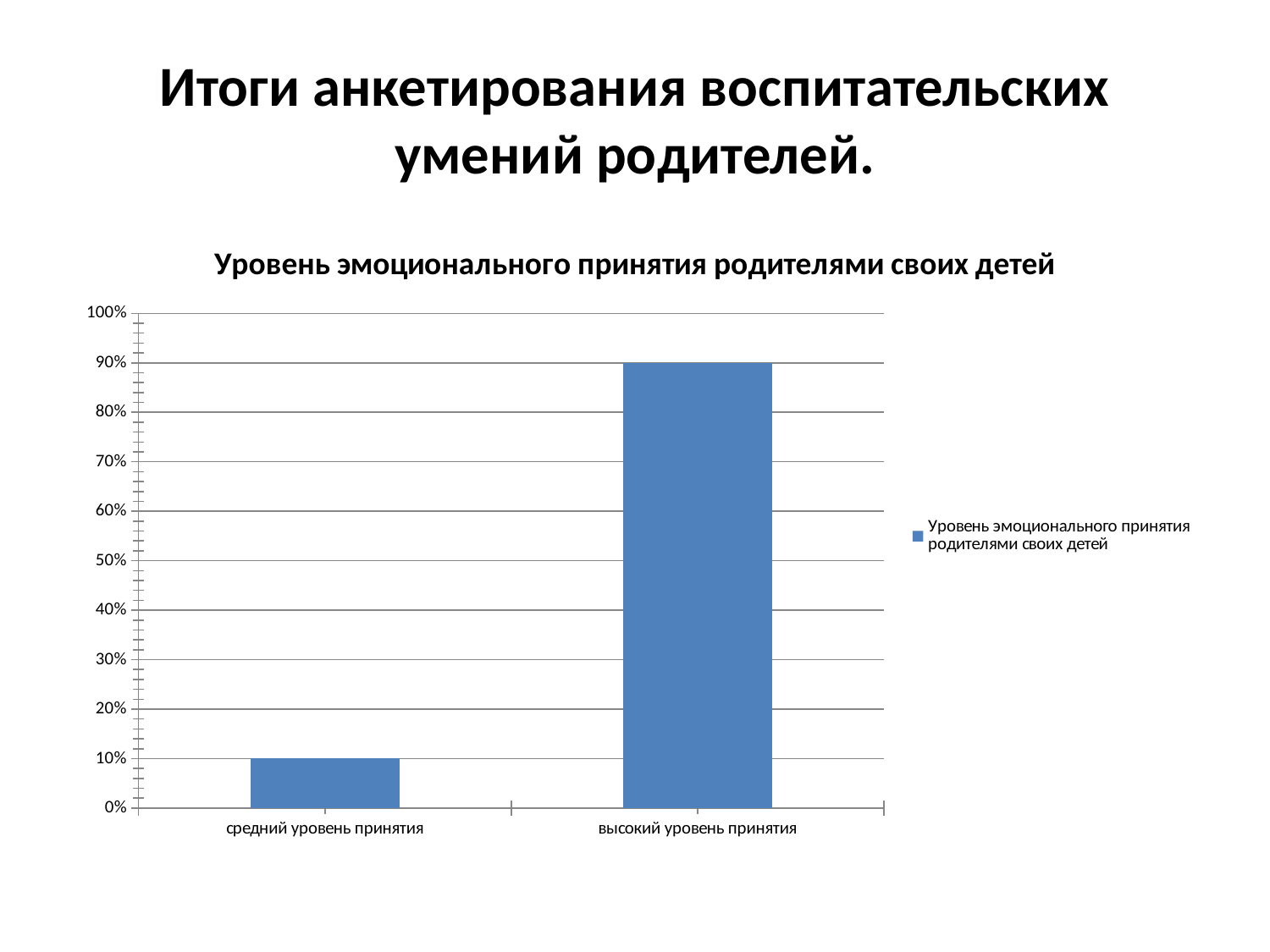
Which is larger: the value for "средний уровень принятия" or the value for "высокий уровень принятия"? высокий уровень принятия What is the value for "средний уровень принятия"? 10% What is the difference between the values for "высокий уровень принятия" and "средний уровень принятия"? 80% Is the value for "высокий уровень принятия" greater or less than 50%? greater How many categories are shown on the x axis? 2 Which category has the lowest value? средний уровень принятия Is the value for "средний уровень принятия" greater or less than 20%? less Which category has the highest value? высокий уровень принятия What is the value for "высокий уровень принятия"? 90% How many series does the legend list? 1 What is the title of the chart? Уровень эмоционального принятия родителями своих детей What kind of chart is shown on the slide? bar chart